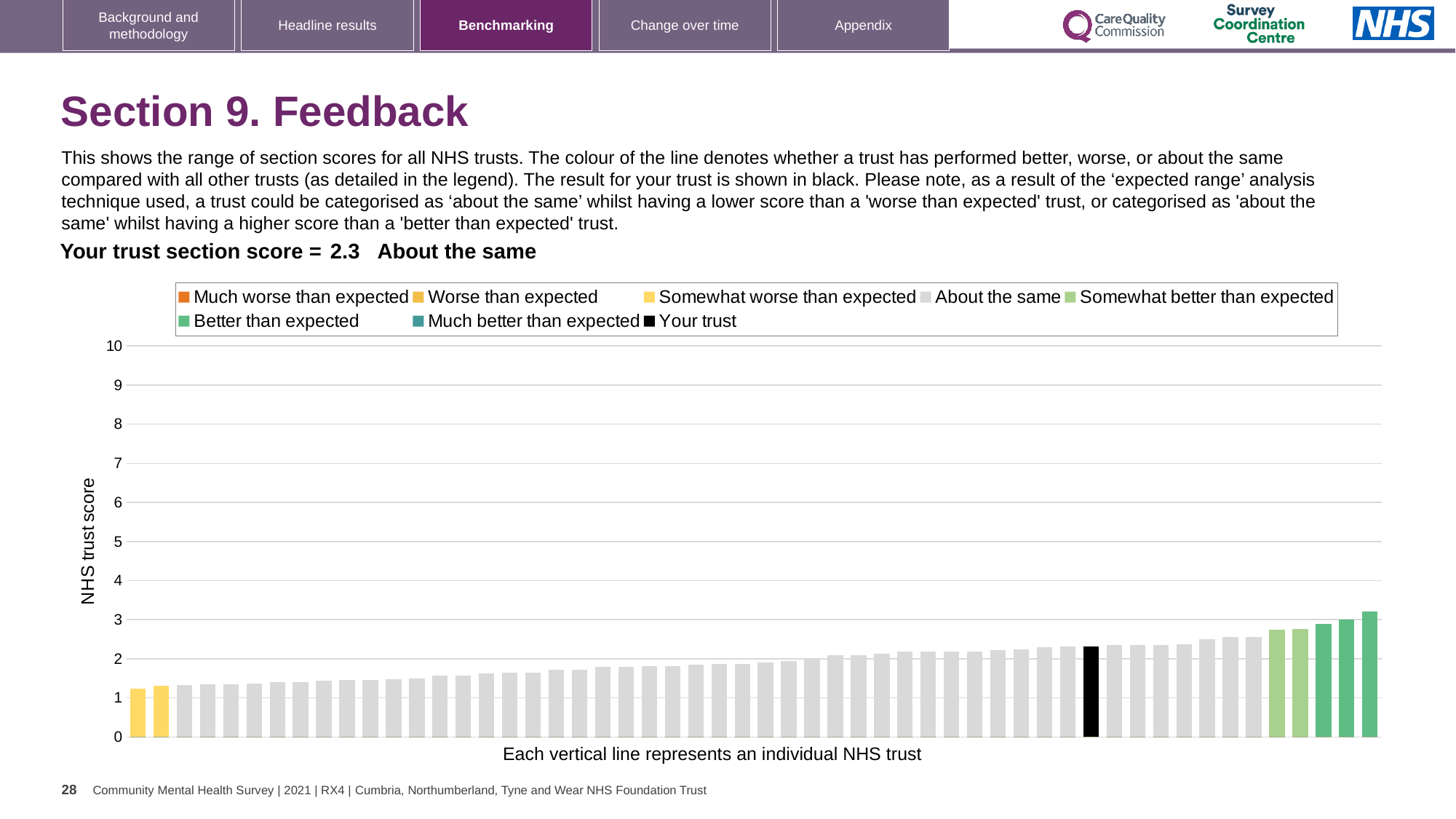
What kind of chart is shown on the slide? bar chart Is the value of the shortest bar in the chart greater or less than 2? less Is the value of the tallest bar in the chart greater or less than 3? greater Do the bar values rise or fall from left to right along the x axis? rise What is the section score for your trust shown on the slide? 2.3 Is the value of the tallest bar in the chart greater or less than 4? less Which performance category is your trust placed in for the Feedback section? About the same What is the label on the vertical axis of the chart? NHS trust score How many entries does the chart legend list? 8